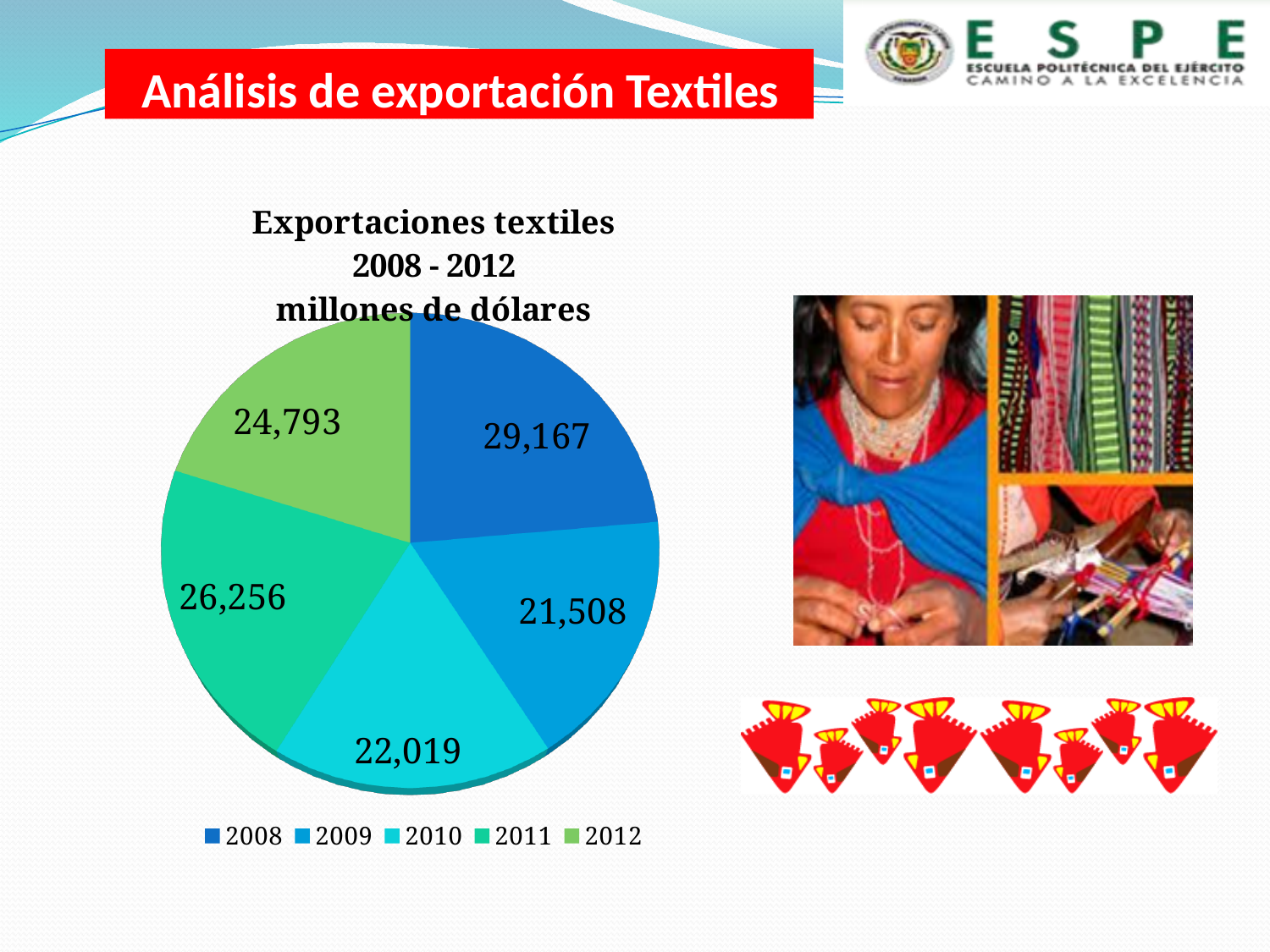
What is the title of the chart? Exportaciones textiles 2008 - 2012 millones de dólares What is the value for 2010 in the pie chart? 22,019 Which is larger, the value for 2010 or the value for 2009? 2010 Which year has the smallest slice in the pie chart? 2009 What is the difference between the values for 2011 and 2012? 1,463 What is the value for 2012 in the pie chart? 24,793 What is the value for 2008 in the pie chart? 29,167 What is the difference between the values for 2008 and 2009? 7,659 What kind of chart is shown on the slide? Pie chart Which year has the largest slice in the pie chart? 2008 What is the value for 2011 in the pie chart? 26,256 How many slices does the pie chart have? 5